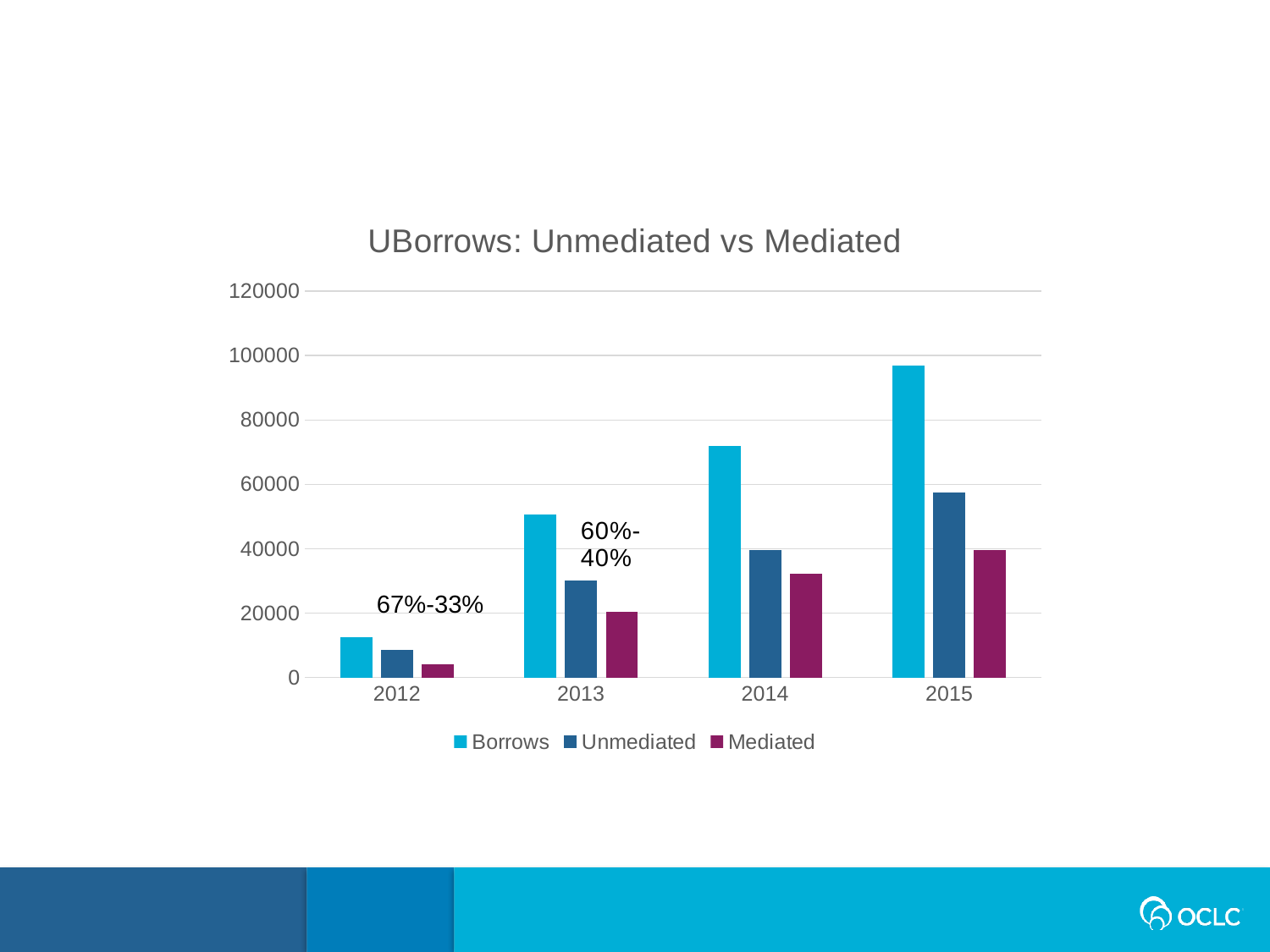
Which is larger: the Unmediated value for 2014 or the Borrows value for 2013? Borrows value for 2013 In which year is the Borrows value highest? 2015 In which year is the Mediated value lowest? 2012 What is the title of the chart? UBorrows: Unmediated vs Mediated Is the Unmediated value for 2015 greater or less than 40000? greater How many series does the legend list? 3 What kind of chart is shown on the slide? bar chart Is the Borrows value for 2014 greater or less than 60000? greater Is the Borrows value for 2012 greater or less than 20000? less Do the Borrows values rise or fall from 2012 to 2015? rise How many years are shown on the x axis? 4